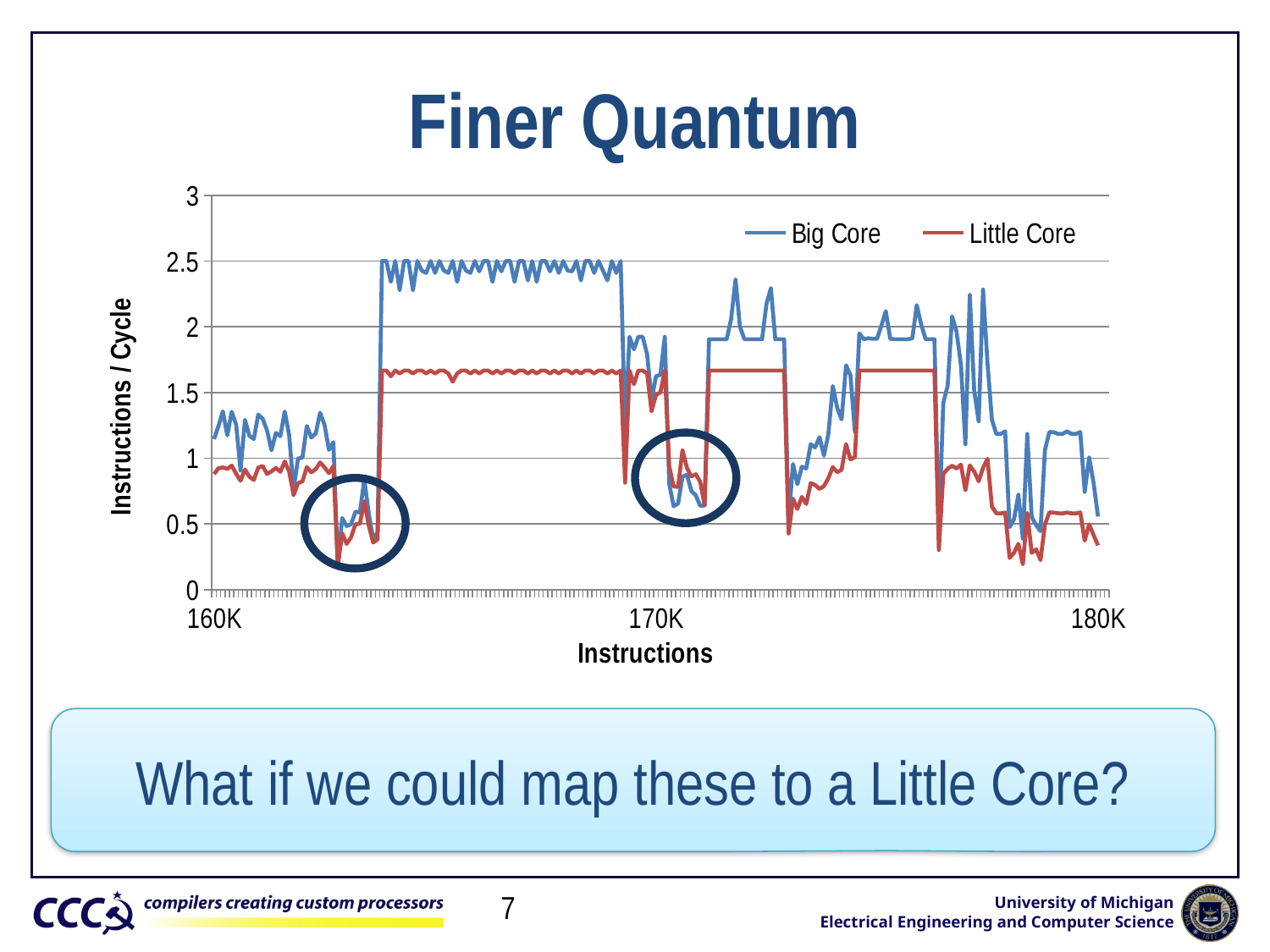
What kind of chart is shown on the slide? line chart Which series stays higher than the other across most of the chart, Big Core or Little Core? Big Core How many series does the chart's legend list? 2 What are the two series named in the chart's legend? Big Core and Little Core Near 180K instructions, is the Little Core value greater or less than 1? less Around 165K instructions, which series has the higher instructions per cycle, Big Core or Little Core? Big Core Around 165K instructions, is the Little Core value greater or less than 1.5? greater Around 175K instructions, which series has the higher instructions per cycle, Big Core or Little Core? Big Core Around 165K instructions, is the Big Core value greater or less than 2? greater What is the label on the chart's vertical axis? Instructions / Cycle